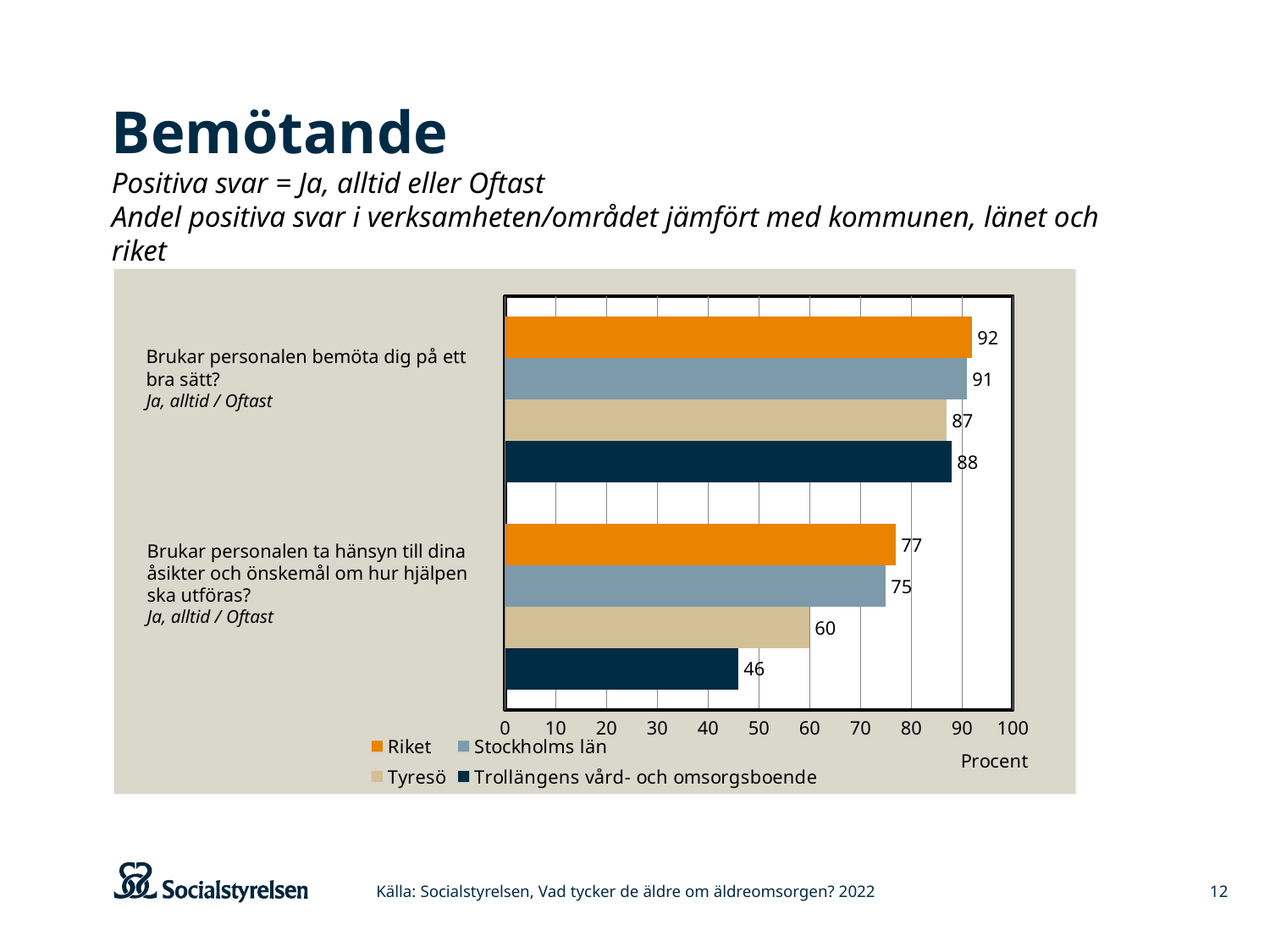
What value is shown for Trollängens vård- och omsorgsboende on the question "Brukar personalen ta hänsyn till dina åsikter och önskemål om hur hjälpen ska utföras?"? 46 What value is shown for Tyresö on the question "Brukar personalen bemöta dig på ett bra sätt?"? 87 Which series has the highest value on the question "Brukar personalen bemöta dig på ett bra sätt?"? Riket Is the value for Tyresö on the question "Brukar personalen ta hänsyn till dina åsikter och önskemål om hur hjälpen ska utföras?" greater or less than 70? less Which series has the lowest value on the question "Brukar personalen ta hänsyn till dina åsikter och önskemål om hur hjälpen ska utföras?"? Trollängens vård- och omsorgsboende What value is shown for Riket on the question "Brukar personalen bemöta dig på ett bra sätt?"? 92 What value is shown for Stockholms län on the question "Brukar personalen ta hänsyn till dina åsikter och önskemål om hur hjälpen ska utföras?"? 75 Which is larger on the question "Brukar personalen bemöta dig på ett bra sätt?": Tyresö or Trollängens vård- och omsorgsboende? Trollängens vård- och omsorgsboende What is the label on the horizontal axis of the chart? Procent What is the difference between Riket and Trollängens vård- och omsorgsboende on the question "Brukar personalen ta hänsyn till dina åsikter och önskemål om hur hjälpen ska utföras?"? 31 How many series does the legend list? 4 What kind of chart is shown on the slide? bar chart